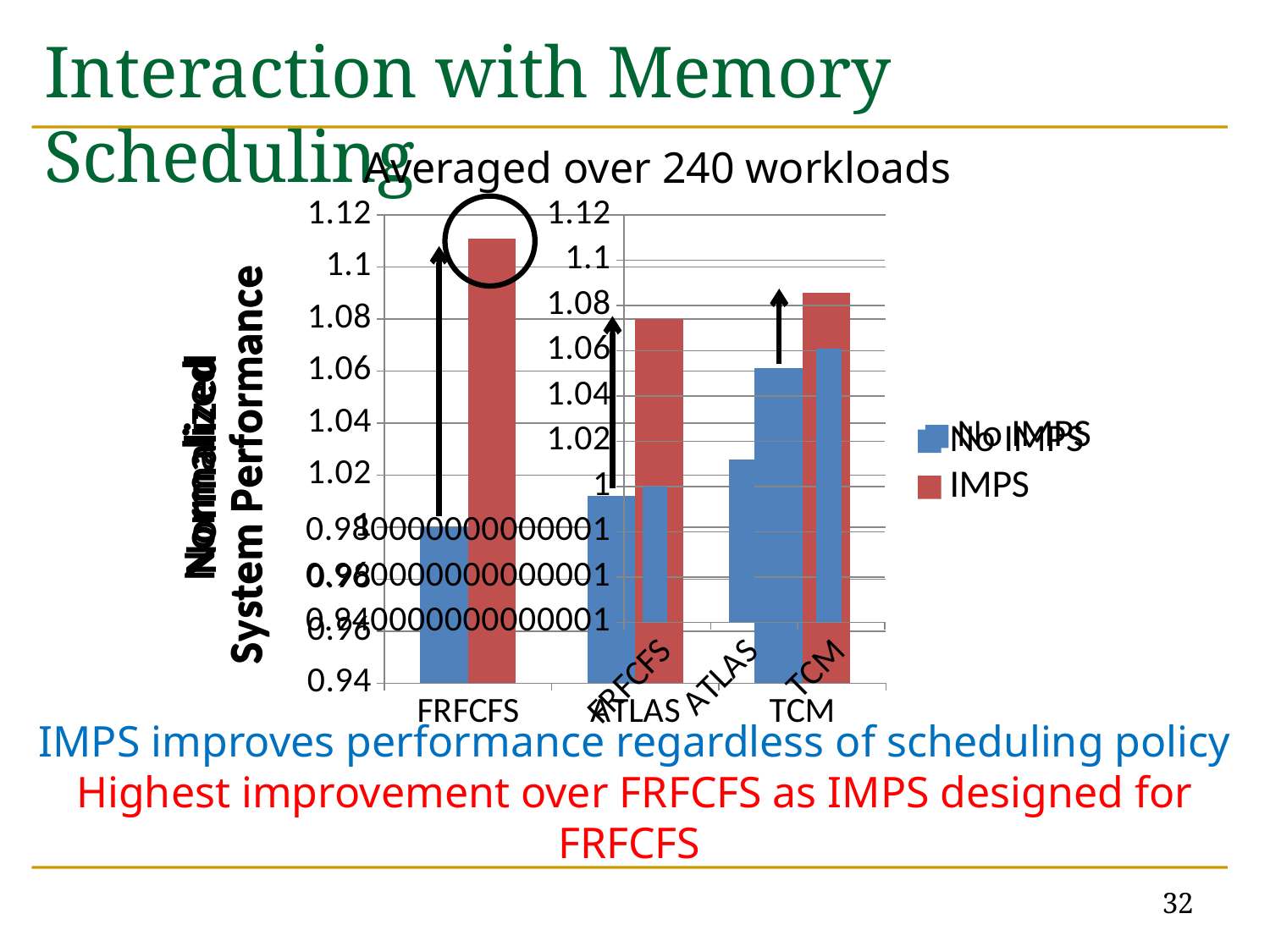
For TCM, which bar is taller: IMPS or No IMPS? IMPS How many scheduling policy categories are shown on the x axis of the chart? 3 What kind of chart is shown on the slide? bar chart For FRFCFS, which bar is taller: IMPS or No IMPS? IMPS Which category shows the largest improvement of IMPS over No IMPS? FRFCFS What are the two series named in the chart legend? No IMPS and IMPS How many series does the chart legend list? 2 Which category has the tallest IMPS bar? FRFCFS Which category has the shortest No IMPS bar? FRFCFS What is the title shown above the chart? Averaged over 240 workloads